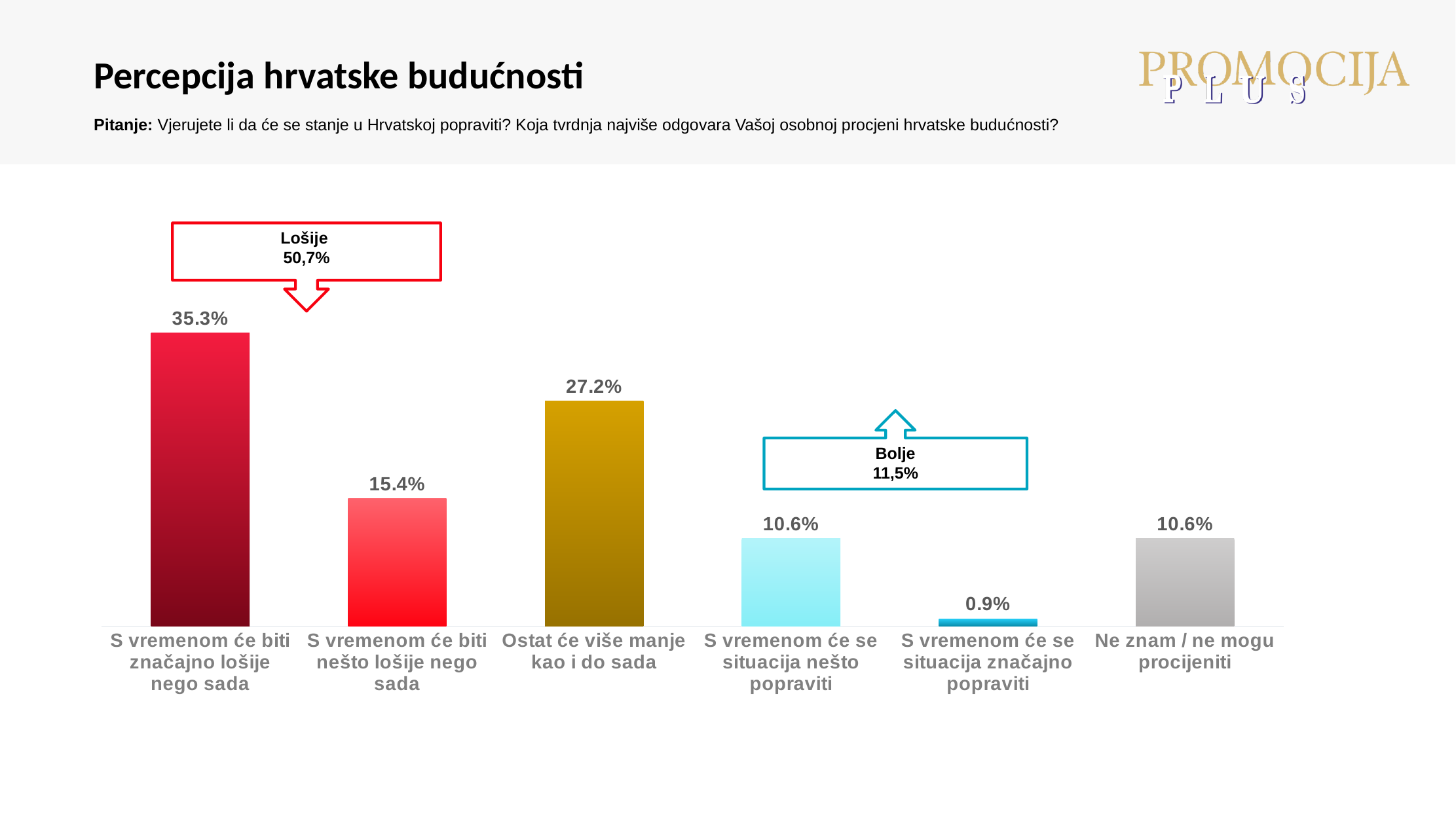
How many categories are shown in the chart? 6 What combined percentage does the "Bolje" callout box show? 11,5% What value is shown for "S vremenom će biti značajno lošije nego sada"? 35.3% Which category has the lowest value? S vremenom će se situacija značajno popraviti What kind of chart is shown on the slide? Bar chart What value is shown for "Ostat će više manje kao i do sada"? 27.2% What is the difference between "S vremenom će biti značajno lošije nego sada" and "S vremenom će biti nešto lošije nego sada"? 19.9% What value is shown for "Ne znam / ne mogu procijeniti"? 10.6% Which is larger: "Ostat će više manje kao i do sada" or "S vremenom će biti nešto lošije nego sada"? Ostat će više manje kao i do sada What value is shown for "S vremenom će se situacija značajno popraviti"? 0.9% What combined percentage does the "Lošije" callout box show? 50,7% Which category has the highest value? S vremenom će biti značajno lošije nego sada